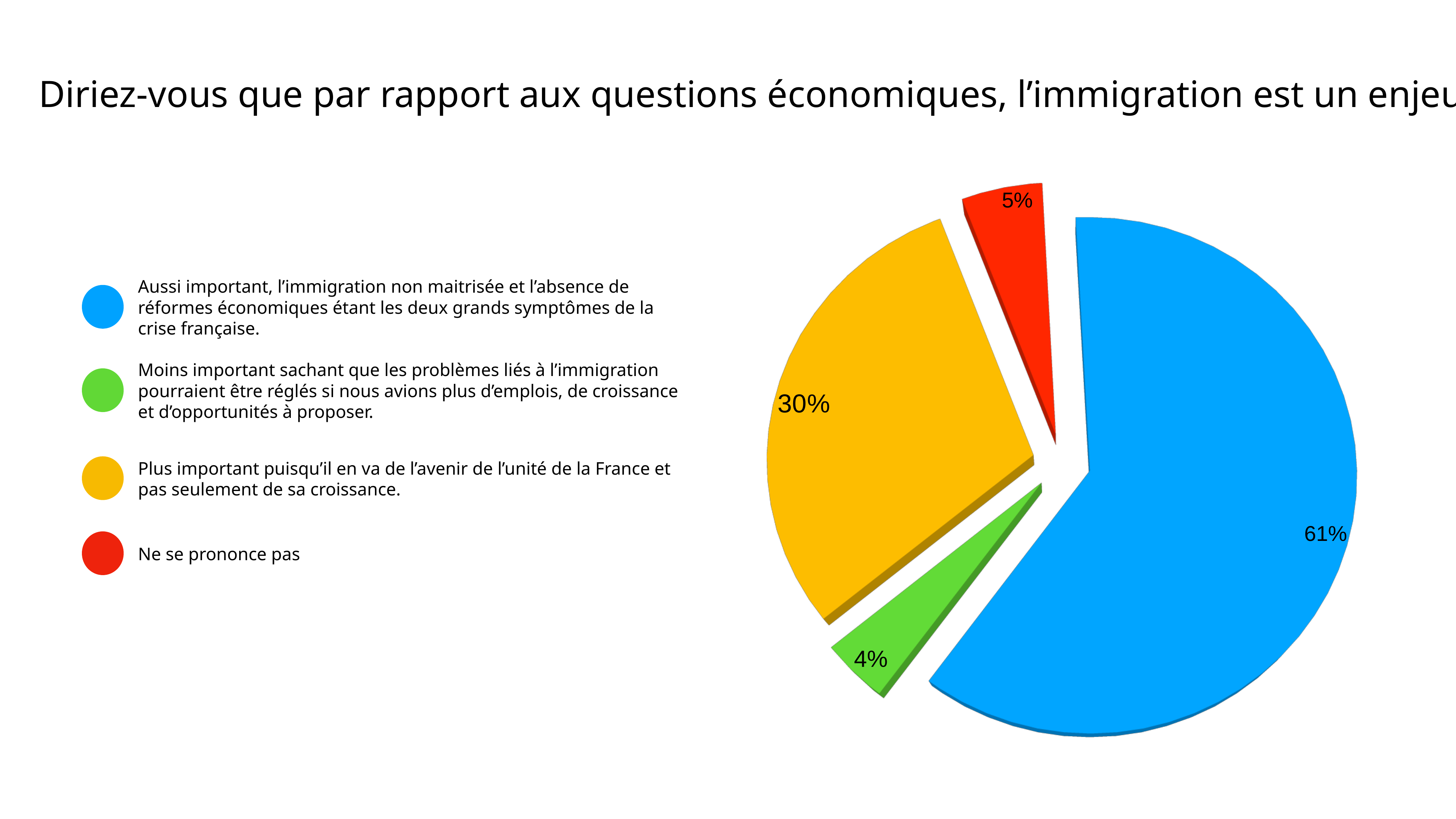
How many slices does the pie chart have? 4 Which response has the smallest share of the pie? Moins important (4%) Which response has the largest share of the pie? Aussi important (61%) What percentage is shown for the green slice ("Moins important...")? 4% What colour is the slice representing "Ne se prononce pas"? red Which is larger, the share for "Ne se prononce pas" or the share for "Moins important"? Ne se prononce pas What share of the pie does the blue slice ("Aussi important...") represent? 61% What kind of chart is shown on the slide? pie chart What is the difference in percentage points between the "Aussi important" slice and the "Plus important" slice? 31 What colour is the slice representing "Plus important puisqu'il en va de l'avenir de l'unité de la France"? yellow What percentage is shown for the yellow slice ("Plus important...")? 30% What percentage is shown for "Ne se prononce pas"? 5%